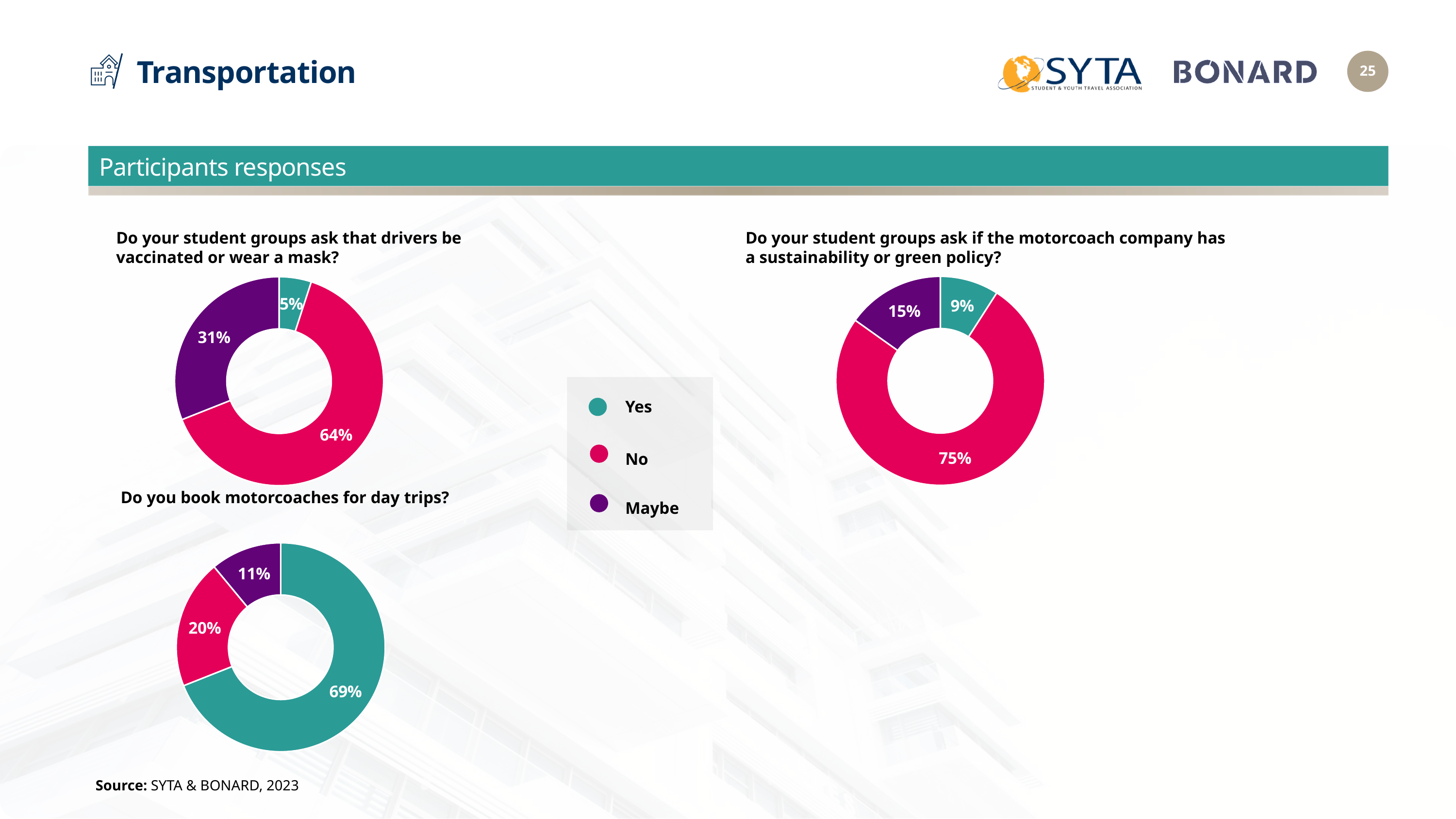
In the chart 'Do your student groups ask if the motorcoach company has a sustainability or green policy?', what percentage answered Yes? 9% In the chart 'Do you book motorcoaches for day trips?', what is the difference between the Yes and No shares? 49% What kind of chart is used for 'Do you book motorcoaches for day trips?' Doughnut chart In the chart 'Do you book motorcoaches for day trips?', which is larger, the No share or the Maybe share? No Which colour represents the Maybe response in the legend? Purple In the chart 'Do your student groups ask that drivers be vaccinated or wear a mask?', which response has the smallest share? Yes How many response categories does the shared legend list? 3 In the chart 'Do your student groups ask if the motorcoach company has a sustainability or green policy?', what is the difference between the No and Maybe shares? 60% In the chart 'Do your student groups ask if the motorcoach company has a sustainability or green policy?', which response has the largest share? No In the chart 'Do you book motorcoaches for day trips?', what percentage answered Yes? 69% In the chart 'Do your student groups ask that drivers be vaccinated or wear a mask?', what percentage answered Maybe? 31% In the chart 'Do your student groups ask that drivers be vaccinated or wear a mask?', what percentage answered No? 64%